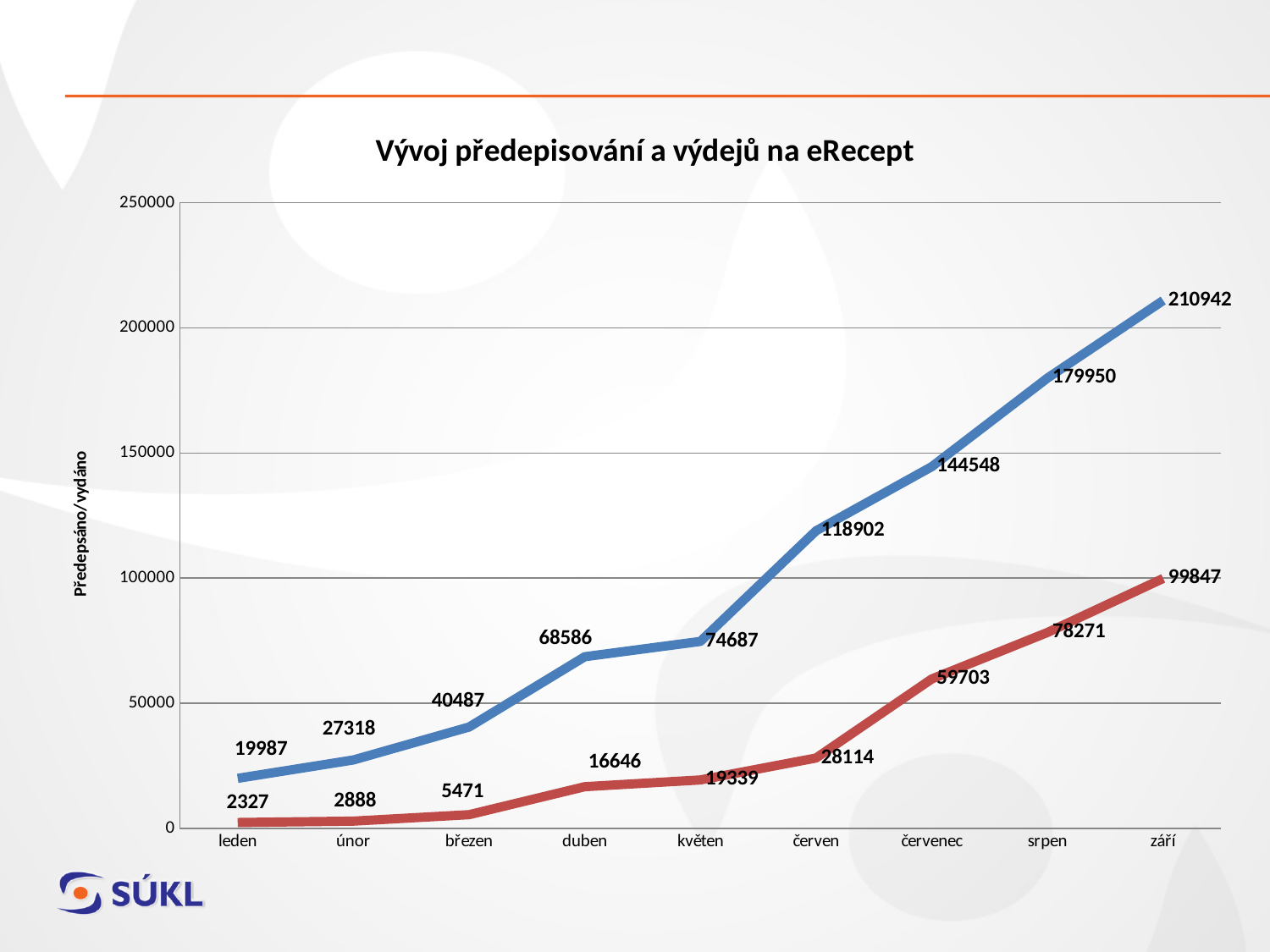
In which month is the blue line at its lowest value? leden What is the value of the blue line for duben? 68586 What is the title of the chart? Vývoj předepisování a výdejů na eRecept Which is larger in červen: the blue line value or the red line value? the blue line value What is the value of the blue line for září? 210942 What is the value of the red line for červenec? 59703 What is the difference between the blue line and the red line in září? 111095 What is the value of the red line for leden? 2327 Do the values of the blue line rise or fall from leden to září? rise What kind of chart is shown on the slide? line chart How many months are shown on the x axis? 9 In which month does the red line reach its highest value? září